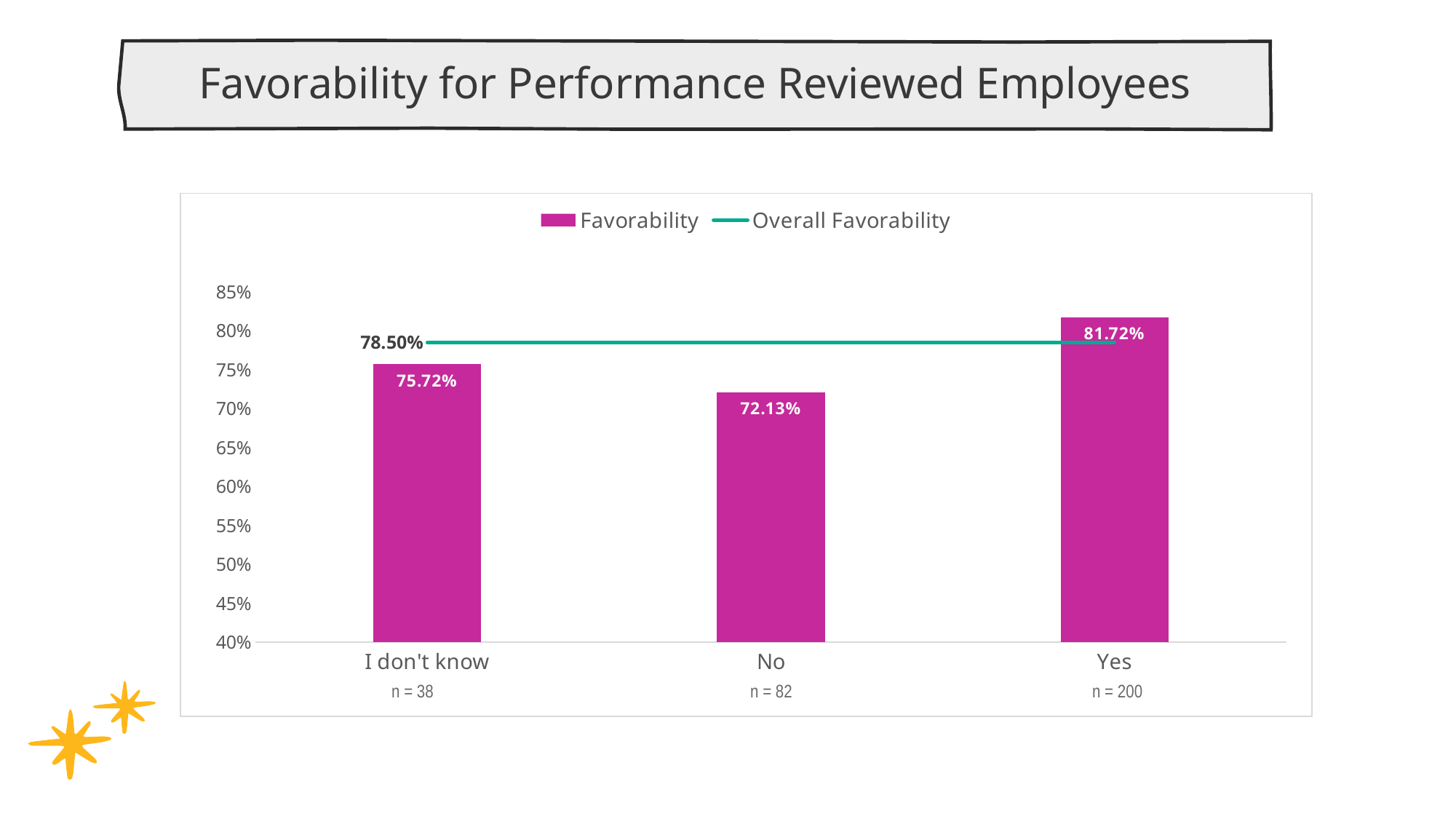
What is the Overall Favorability value shown by the line? 78.50% What is the Favorability value for the "I don't know" category? 75.72% What is the difference in Favorability between "Yes" and "No"? 9.59% Which category has the highest Favorability? Yes Which category has the lowest Favorability? No What is the Favorability value for the "Yes" category? 81.72% How many categories are shown on the x axis? 3 What kind of chart is shown on the slide? Bar chart with a line What is the sample size (n) for the "Yes" category? n = 200 Which has a higher Favorability, "I don't know" or "No"? I don't know What is the Favorability value for the "No" category? 72.13% How many series does the legend list? 2